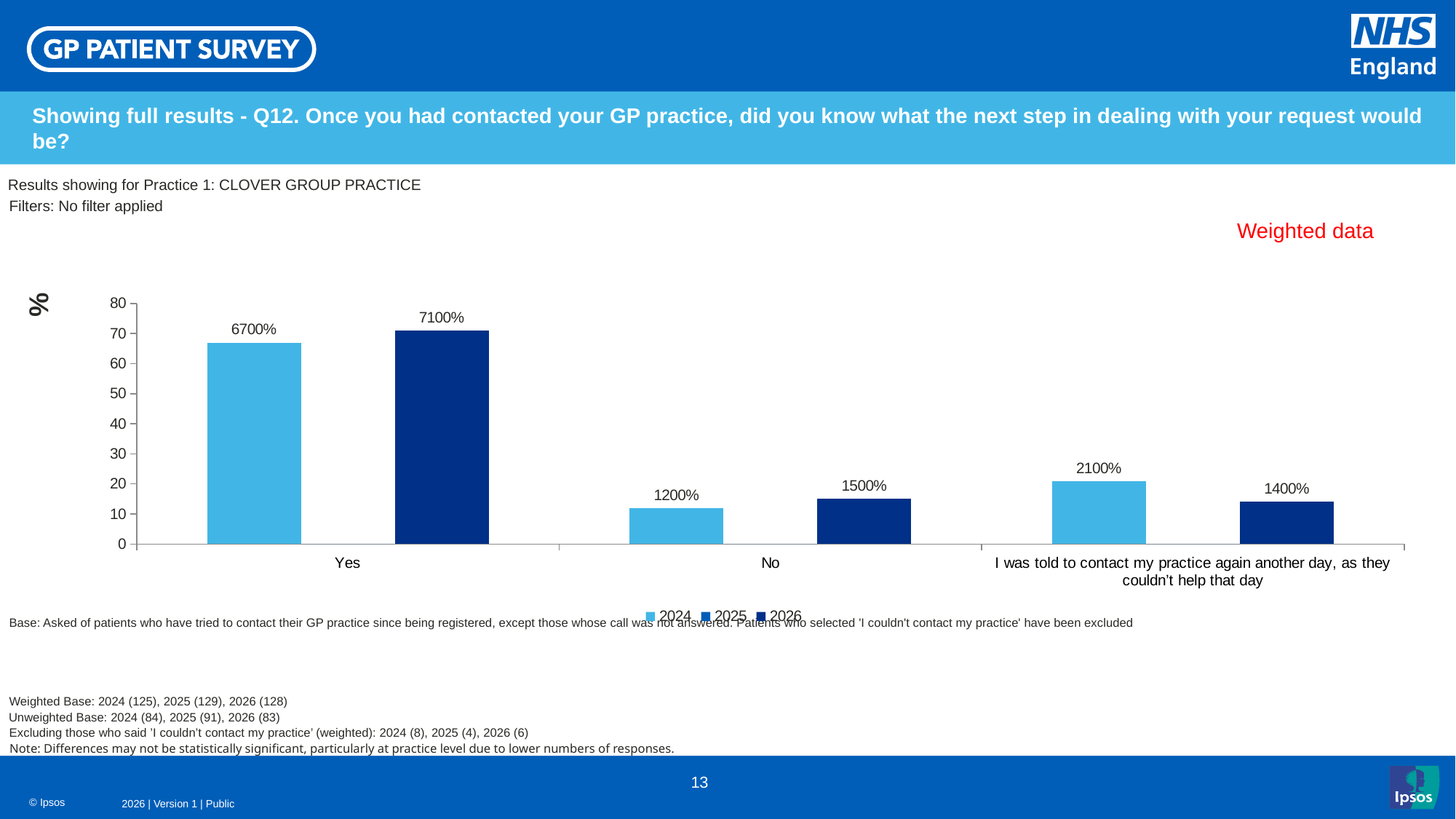
What is the value of the 2026 (dark blue) bar for 'Yes'? 7100% How many categories are shown on the x axis? 3 What is the value of the 2024 (light blue) bar for 'Yes'? 6700% What is the value of the 2026 (dark blue) bar for 'I was told to contact my practice again another day, as they couldn't help that day'? 1400% How many series does the legend list? 3 What is the value of the 2024 (light blue) bar for 'I was told to contact my practice again another day, as they couldn't help that day'? 2100% For 'No', which bar is larger: 2024 (light blue) or 2026 (dark blue)? 2026 Which category has the highest 2024 (light blue) bar? Yes What is the difference between the 2026 and 2024 values for 'Yes'? 400% Which category has the lowest 2024 (light blue) bar? No What is the value of the 2024 (light blue) bar for 'No'? 1200% What is the value of the 2026 (dark blue) bar for 'No'? 1500%